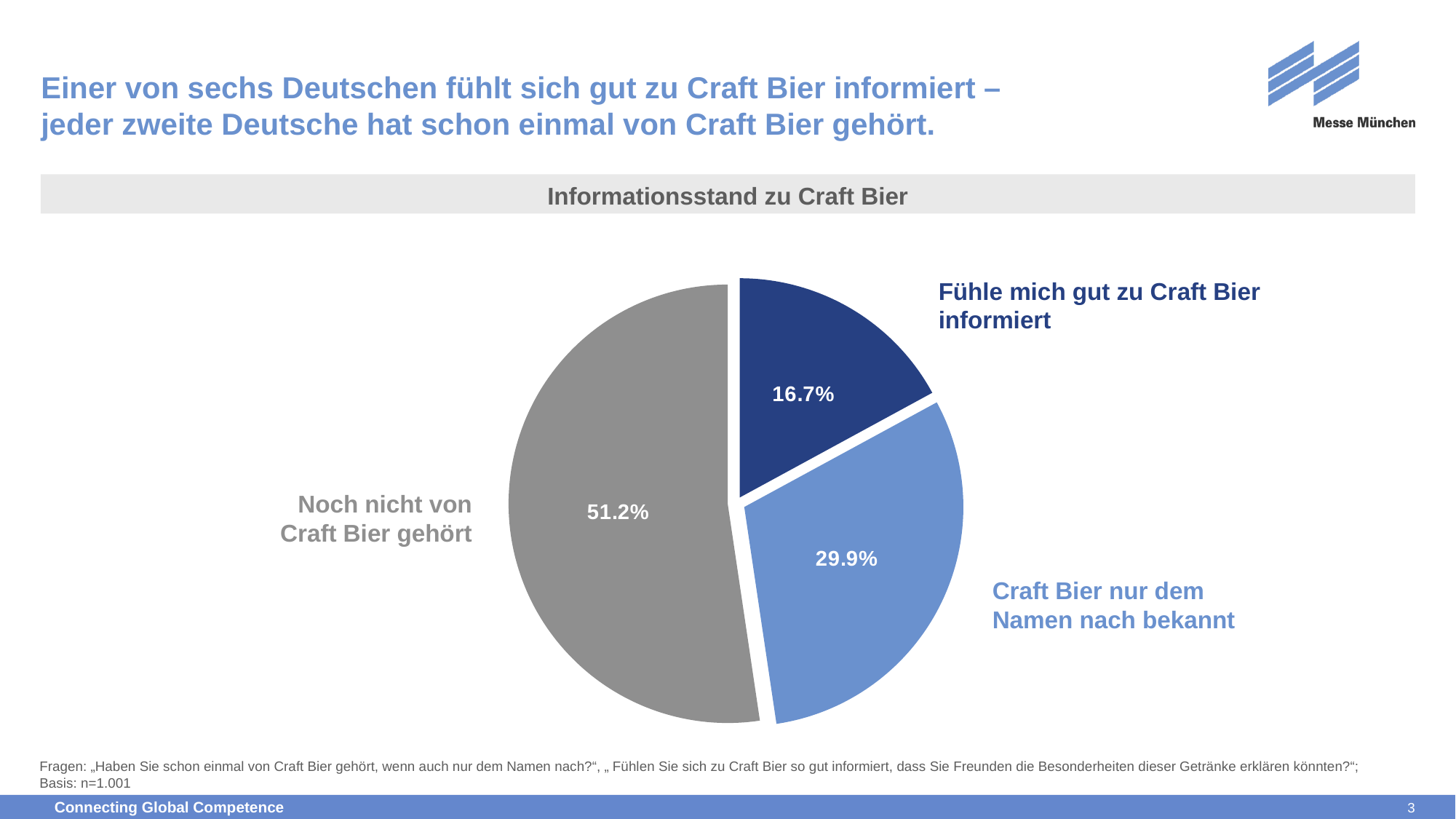
Which slice of the pie is the largest? Noch nicht von Craft Bier gehört Which is larger: the share for 'Craft Bier nur dem Namen nach bekannt' or for 'Fühle mich gut zu Craft Bier informiert'? Craft Bier nur dem Namen nach bekannt What share of respondents say 'Craft Bier nur dem Namen nach bekannt'? 29.9% What is the difference between the 'Noch nicht von Craft Bier gehört' share and the 'Craft Bier nur dem Namen nach bekannt' share? 21.3% What is the difference between the 'Craft Bier nur dem Namen nach bekannt' share and the 'Fühle mich gut zu Craft Bier informiert' share? 13.2% What colour is the 'Noch nicht von Craft Bier gehört' slice? Grey What share of respondents say 'Fühle mich gut zu Craft Bier informiert'? 16.7% How many slices does the pie chart have? 3 What share of respondents say 'Noch nicht von Craft Bier gehört'? 51.2% What is the title of the chart? Informationsstand zu Craft Bier Which slice of the pie is the smallest? Fühle mich gut zu Craft Bier informiert What kind of chart is shown on the slide? Pie chart